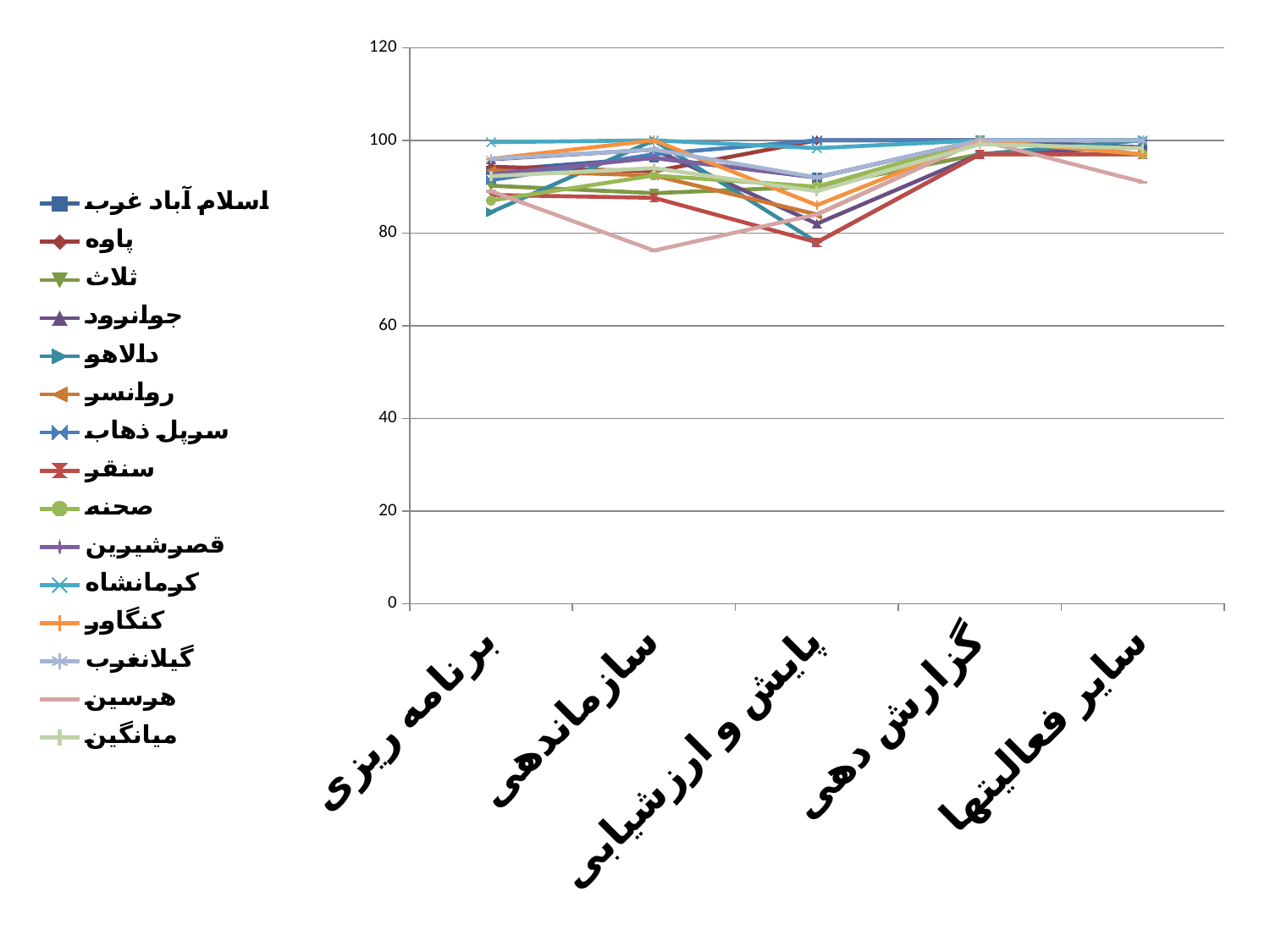
Is the value for هرسین at سایر فعالیتها greater or less than 80? greater Does the value for هرسین rise or fall from گزارش دهی to سایر فعالیتها? fall What is the label of the first category on the x axis? برنامه ریزی Which series has the lowest value at سازماندهی? هرسین Is the value for کرمانشاه at برنامه ریزی greater or less than 80? greater Is the value for پاوه at پایش و ارزشیابی greater or less than 80? greater How many series does the legend list? 15 What is the highest value shown on the y axis? 120 What kind of chart is shown on the slide? line chart How many categories are shown along the x axis? 5